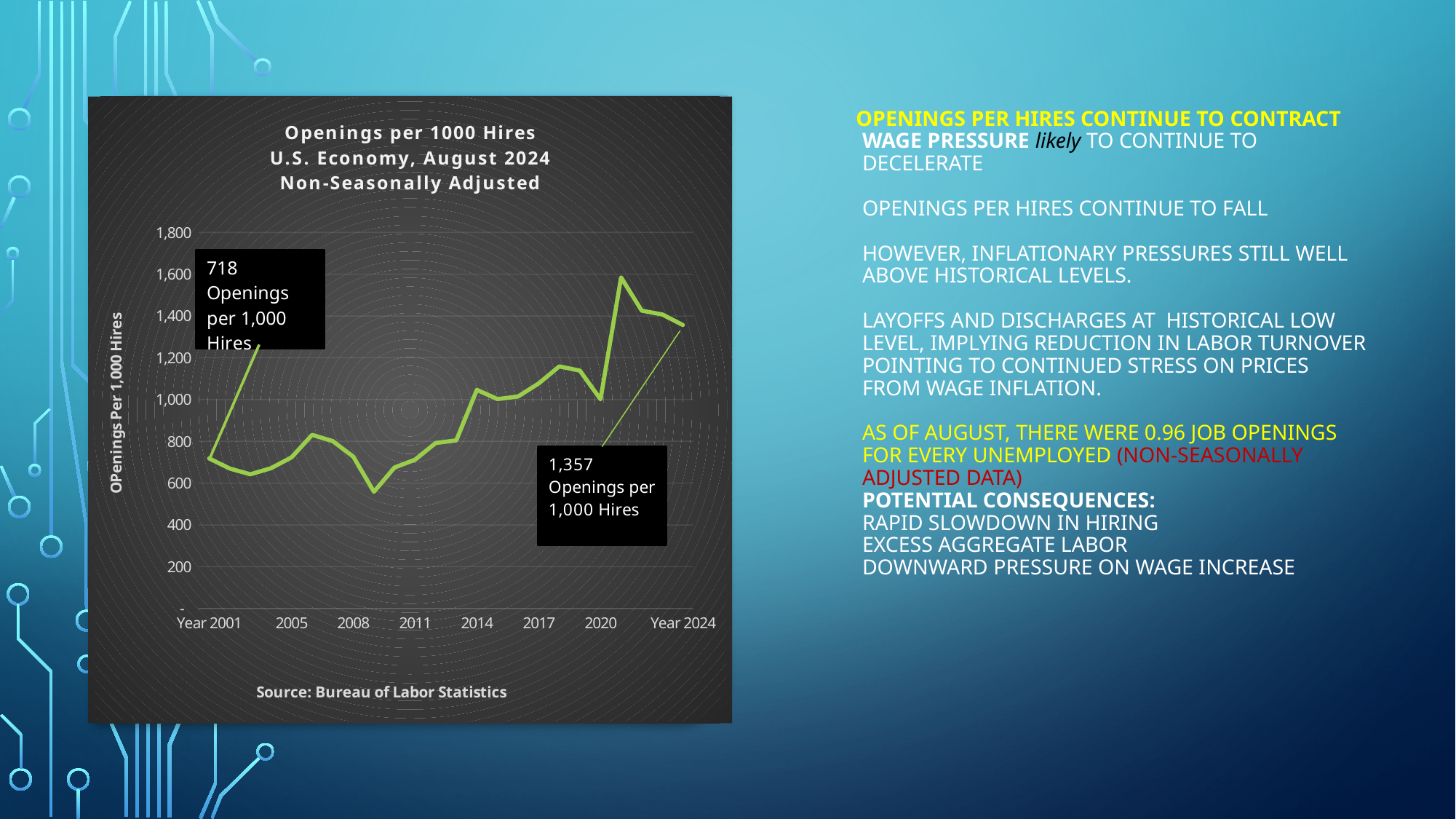
What is the value of openings per 1,000 hires for Year 2001? 718 How many year labels are shown on the x axis? 8 Which year has the larger value of openings per 1,000 hires, Year 2001 or Year 2024? Year 2024 How many lines are plotted on the chart? 1 What kind of chart is shown on the slide? Line chart What source is cited below the chart? Bureau of Labor Statistics Is the value for 2008 greater or less than 1,000? less What is the value of openings per 1,000 hires for Year 2024? 1,357 Overall, do the values rise or fall from Year 2001 to Year 2024? Rise Is the highest point on the line, between 2020 and Year 2024, greater or less than 1,400? greater What is the difference between the openings per 1,000 hires in Year 2024 and Year 2001? 639 Is the value for 2020 greater or less than 1,200? less